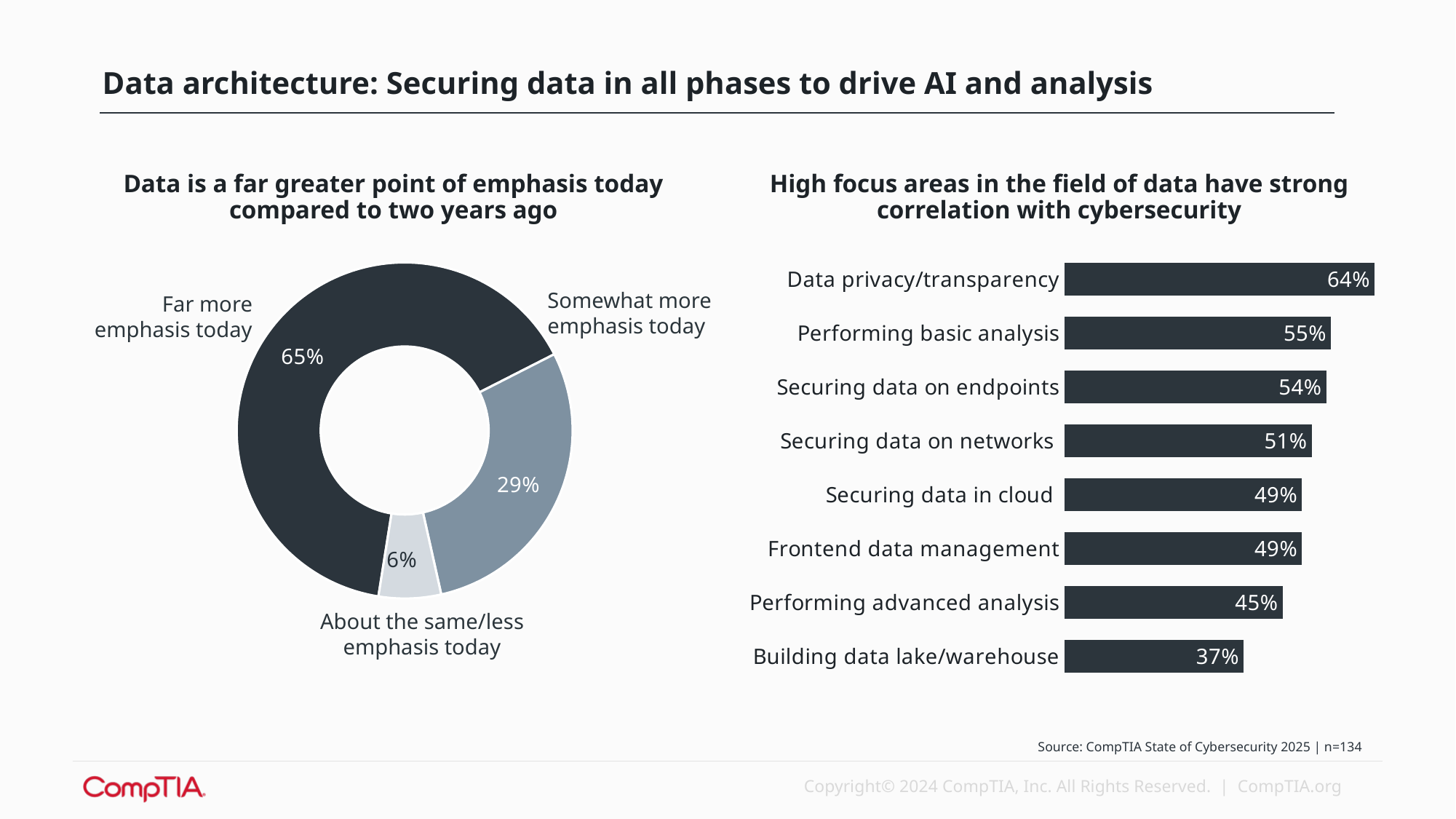
What kind of chart is the one on the left side of the slide? Doughnut (pie) chart In the chart titled 'High focus areas in the field of data have strong correlation with cybersecurity', what is the value for 'Securing data on networks'? 51% In the chart titled 'Data is a far greater point of emphasis today compared to two years ago', what is the value for 'About the same/less emphasis today'? 6% What kind of chart is the one on the right side of the slide? Bar chart In the chart titled 'High focus areas in the field of data have strong correlation with cybersecurity', which category has the lowest value? Building data lake/warehouse In the chart titled 'Data is a far greater point of emphasis today compared to two years ago', which category has the smallest slice? About the same/less emphasis today In the chart titled 'High focus areas in the field of data have strong correlation with cybersecurity', which category has the highest value? Data privacy/transparency How many categories does the chart on the right side of the slide show? 8 In the chart titled 'High focus areas in the field of data have strong correlation with cybersecurity', which is larger: 'Performing basic analysis' or 'Performing advanced analysis'? Performing basic analysis How many categories does the chart on the left side of the slide show? 3 In the chart titled 'High focus areas in the field of data have strong correlation with cybersecurity', what is the difference between 'Data privacy/transparency' and 'Building data lake/warehouse'? 27 percentage points In the chart titled 'Data is a far greater point of emphasis today compared to two years ago', what share of respondents said 'Far more emphasis today'? 65%